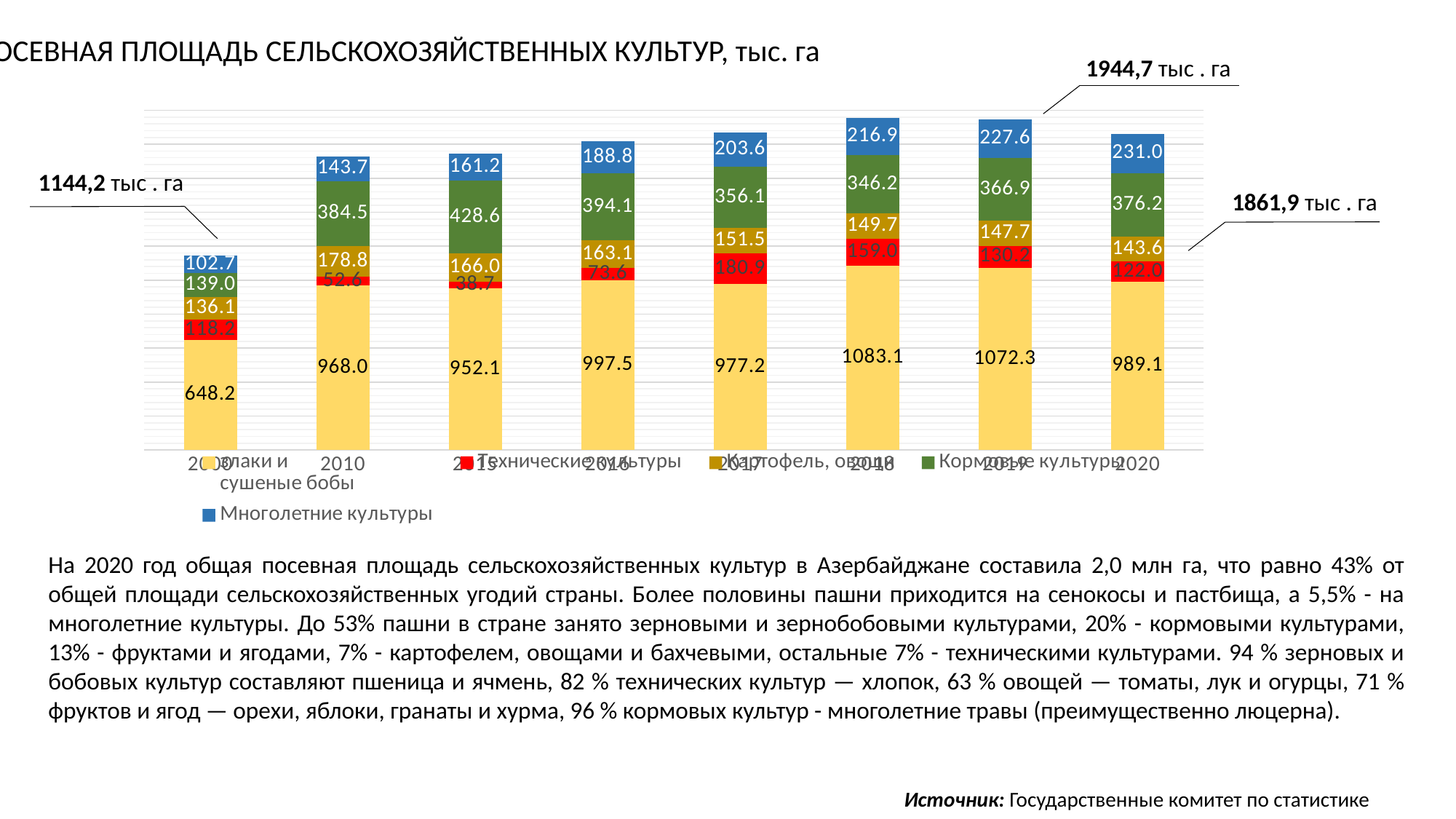
How many years are shown on the x axis of the chart? 8 What is the value for Технические культуры in 2017? 180.9 What kind of chart is shown on the slide? Stacked bar chart In which year is the value for Технические культуры the lowest? 2015 In which year is the value for Злаки и сушеные бобы the highest? 2018 Which is larger, the Кормовые культуры value in 2010 or in 2016? 2016 How many series does the chart legend list? 5 What is the value for Многолетние культуры in 2020? 231.0 Do the values for Многолетние культуры rise or fall from 2000 to 2020? Rise What is the total of the stacked bar for 2020, as annotated on the slide? 1861,9 тыс. га What is the value for Злаки и сушеные бобы in 2018? 1083.1 What is the difference between the Кормовые культуры values in 2015 and 2000? 289.6